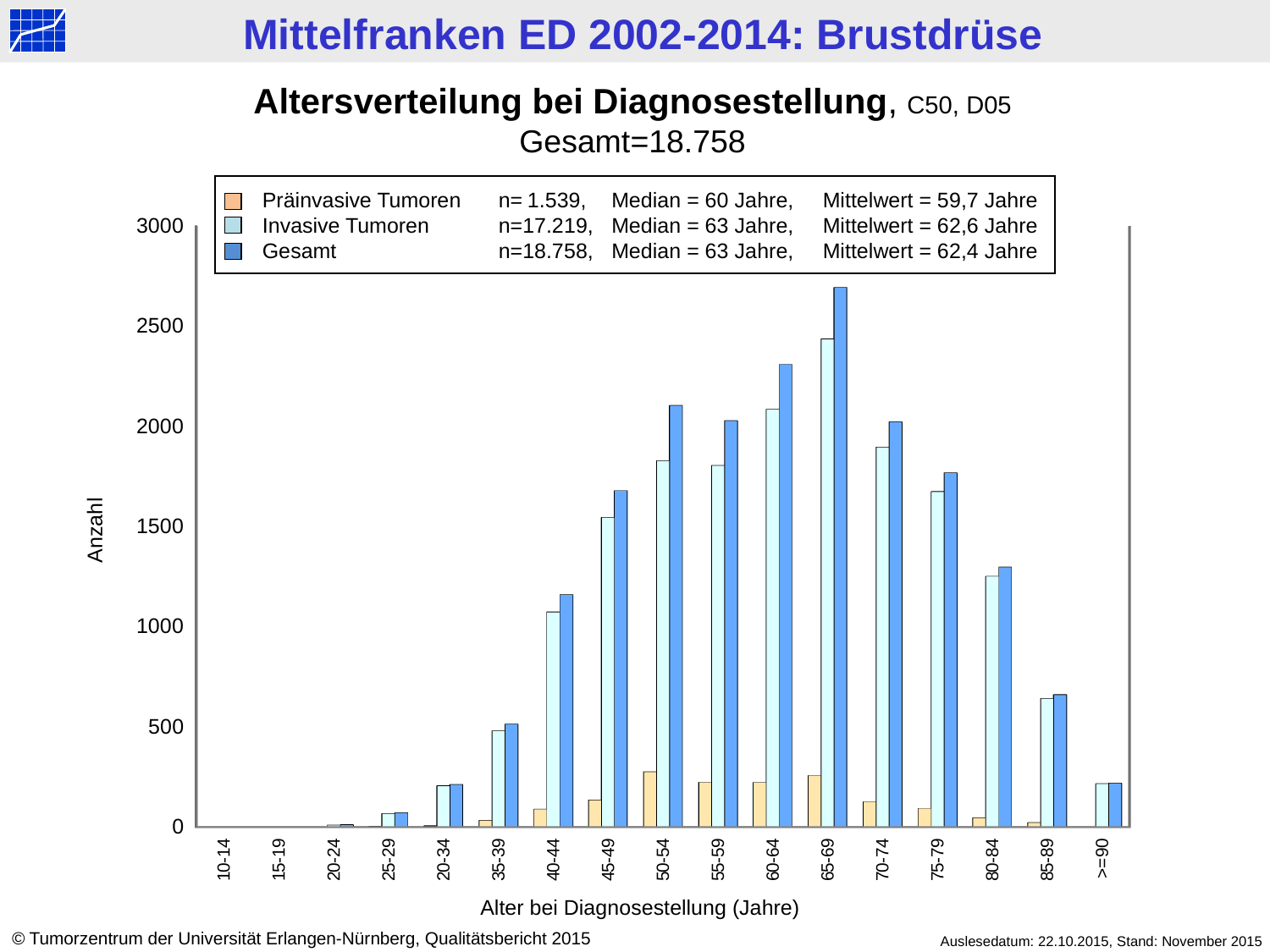
Do the Gesamt values rise or fall from the 65-69 age group to the >=90 age group? fall Which age category has the highest value for the Invasive Tumoren series? 65-69 What kind of chart is shown on the slide? bar chart Which age category has the highest value for the Gesamt series? 65-69 Is the Invasive Tumoren value for the 85-89 age group greater or less than 1000? less Is the Gesamt value for the 65-69 age group greater or less than 2500? greater According to the legend, what is the Median for Invasive Tumoren? 63 Jahre Which is larger for the 50-54 age group: Präinvasive Tumoren or Invasive Tumoren? Invasive Tumoren How many age categories are shown on the x axis? 17 Is the Gesamt value for the 40-44 age group greater or less than 1000? greater How many series does the legend list? 3 According to the legend, what is the n for Präinvasive Tumoren? 1.539